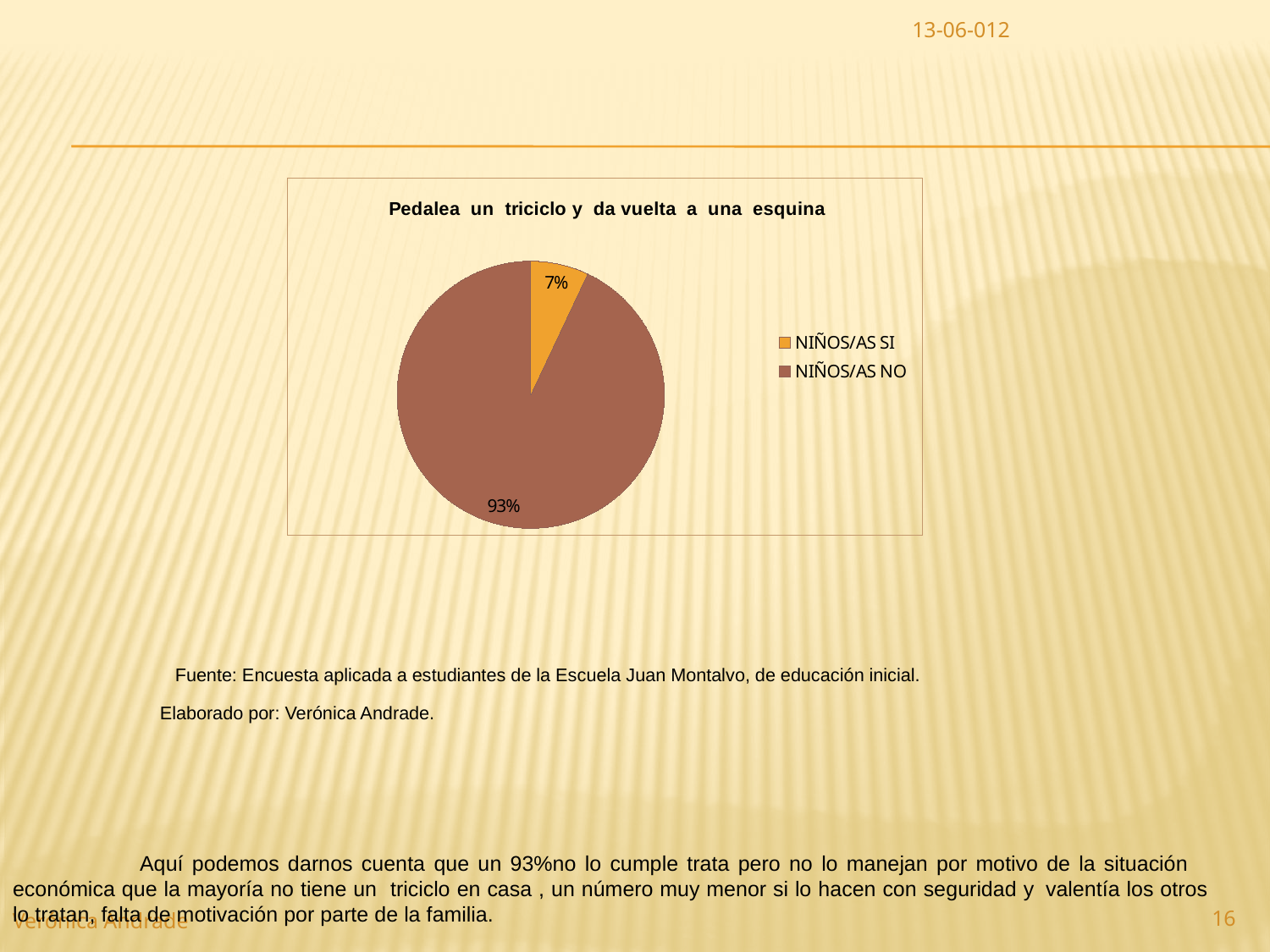
Which category has the smallest share of the pie? NIÑOS/AS SI Which category has the largest share of the pie? NIÑOS/AS NO How many slices does the pie chart have? 2 What percentage is shown for NIÑOS/AS SI? 7% What is the title of the chart? Pedalea un triciclo y da vuelta a una esquina Which is larger, the share for NIÑOS/AS SI or NIÑOS/AS NO? NIÑOS/AS NO What share of the pie does NIÑOS/AS NO represent? 93% How many entries does the legend list? 2 What kind of chart is shown on the slide? pie chart What is the difference in percentage points between NIÑOS/AS NO and NIÑOS/AS SI? 86 What percentage is shown for NIÑOS/AS NO? 93% What colour is the NIÑOS/AS SI slice? orange